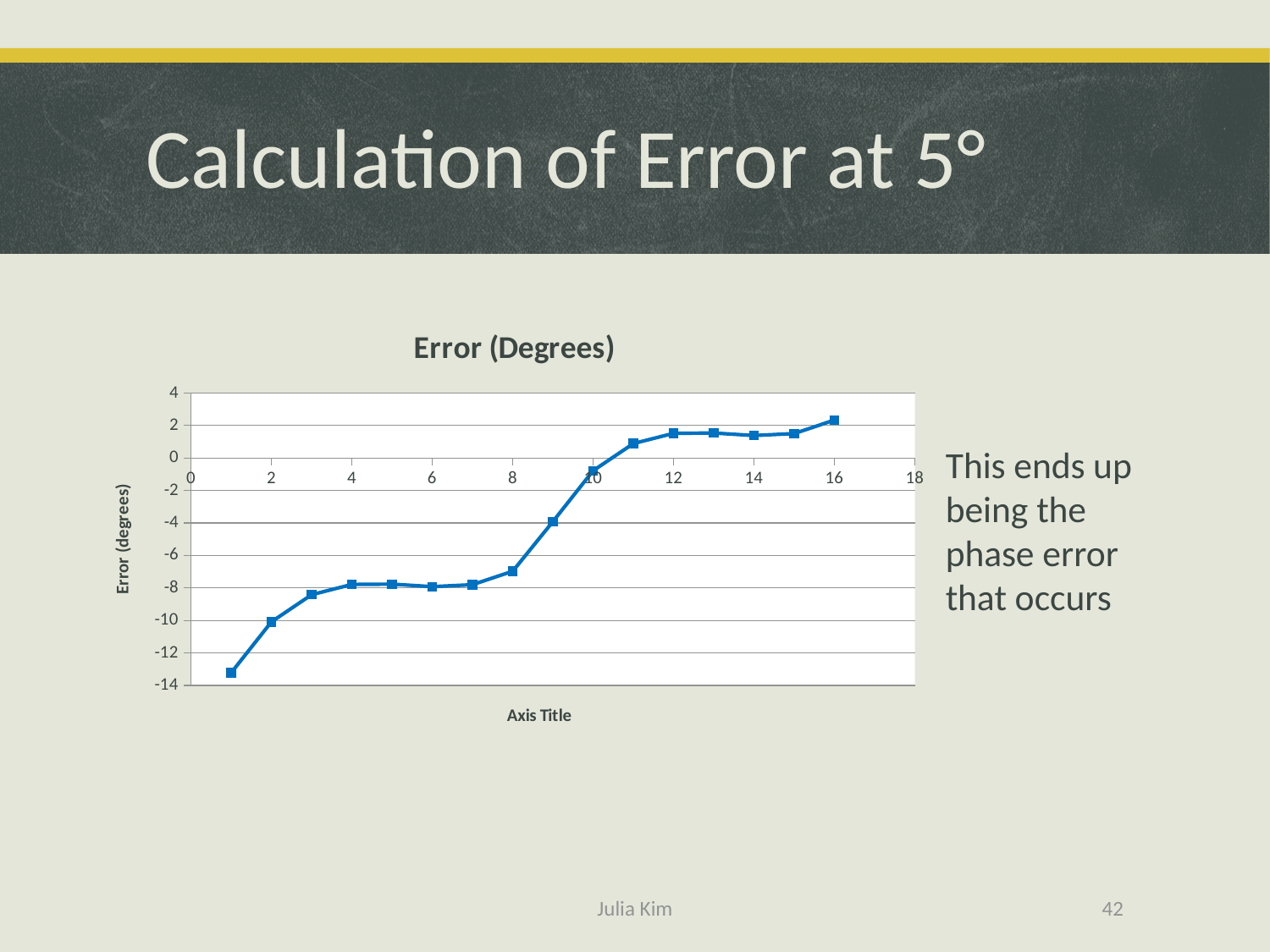
Is the value at x = 2 greater or less than -8? less What is the title of the chart? Error (Degrees) Which has the larger value, the point at x = 3 or the point at x = 11? x = 11 Is the value at x = 16 greater or less than 0? greater Is the value at x = 1 greater or less than -12? less What is the label on the vertical axis of the chart? Error (degrees) How many data points are plotted on the line? 16 At which x value is the plotted error lowest? 1 What kind of chart is shown on the slide? line chart Do the values generally rise or fall as you move from left to right along the x axis? rise At which x value is the plotted error highest? 16